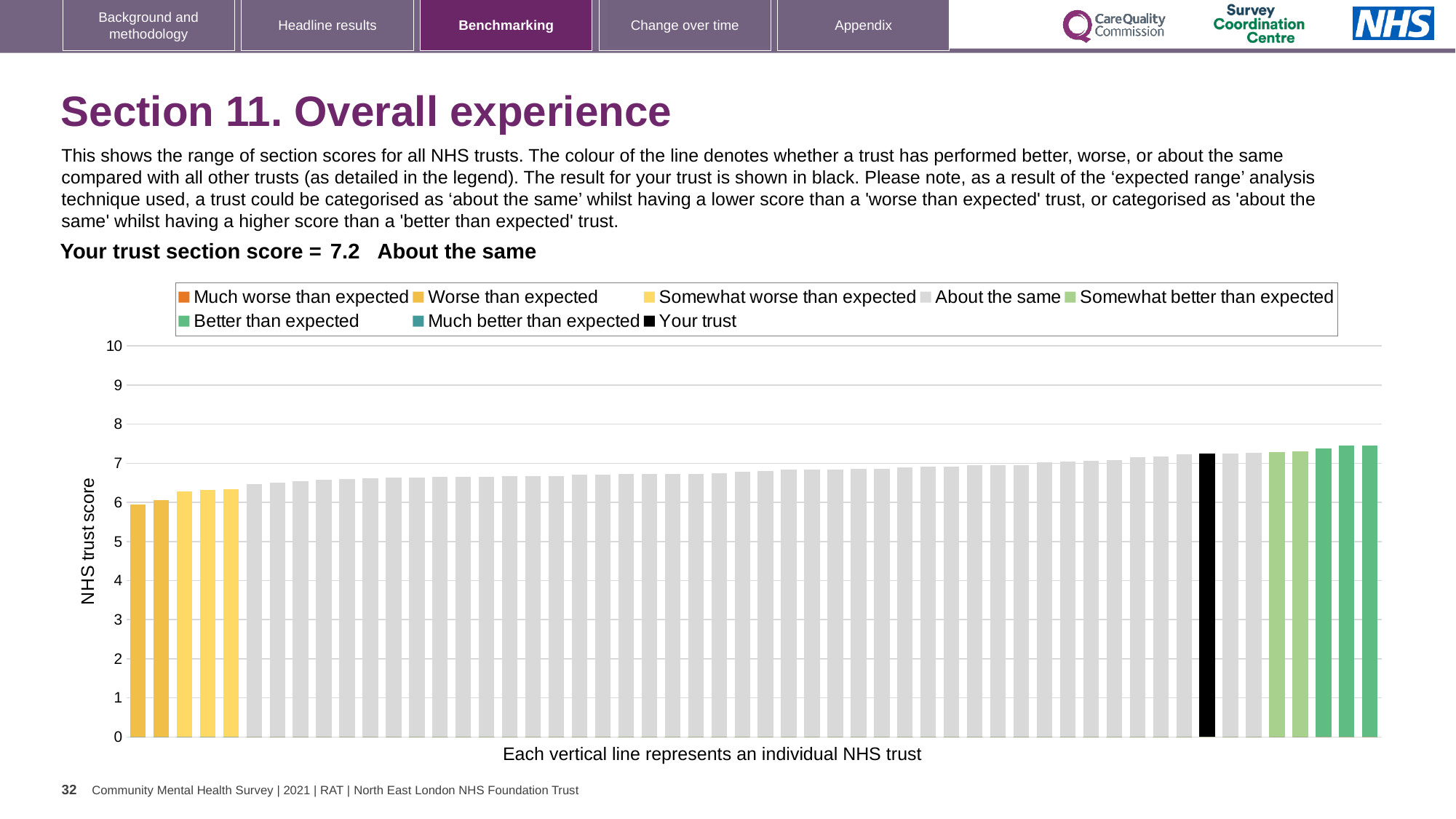
Is the value for your trust (the black bar) greater or less than 7? greater What colour is used for the bar representing your trust? black What is the label on the y axis of the chart? NHS trust score Is the value of the shortest bar greater or less than 5? greater Is the value of the tallest bar greater or less than 8? less Which category is your trust placed in for this section? About the same How many bars are coloured orange for 'Much worse than expected'? 0 What kind of chart is shown on the slide? bar chart How many entries does the chart legend list? 8 Do the bar values rise or fall from left to right along the x axis? rise What is the section score for your trust? 7.2